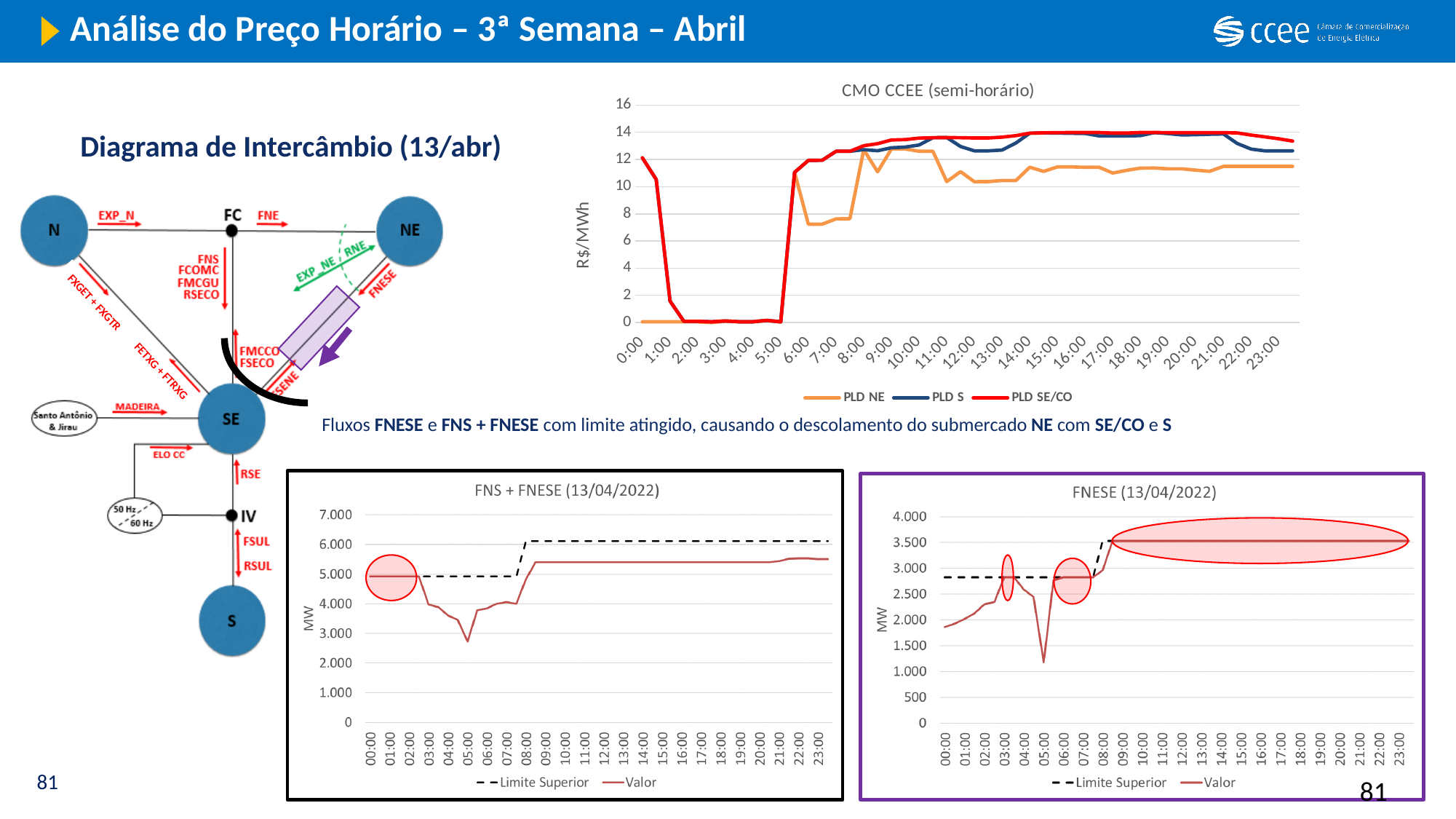
How many series does the legend of the 'FNS + FNESE (13/04/2022)' chart list? 2 Which series are listed in the legend of the 'CMO CCEE (semi-horário)' chart? PLD NE, PLD S, PLD SE/CO In the 'CMO CCEE (semi-horário)' chart, which series is higher at 15:00, PLD SE/CO or PLD NE? PLD SE/CO In the 'FNS + FNESE (13/04/2022)' chart, is the Valor at 15:00 greater or less than 5.000? greater In the 'CMO CCEE (semi-horário)' chart, is the value of PLD NE at 15:00 greater or less than 12? less In the 'FNESE (13/04/2022)' chart, is the Valor at 05:00 greater or less than 1.500? less How many hour labels are shown on the x axis of the 'CMO CCEE (semi-horário)' chart? 24 In the 'CMO CCEE (semi-horário)' chart, does PLD SE/CO rise or fall between 0:00 and 2:00? fall What unit is shown on the y axis of the 'FNESE (13/04/2022)' chart? MW How many series does the legend of the 'CMO CCEE (semi-horário)' chart list? 3 What kind of chart is the 'CMO CCEE (semi-horário)' chart? line chart